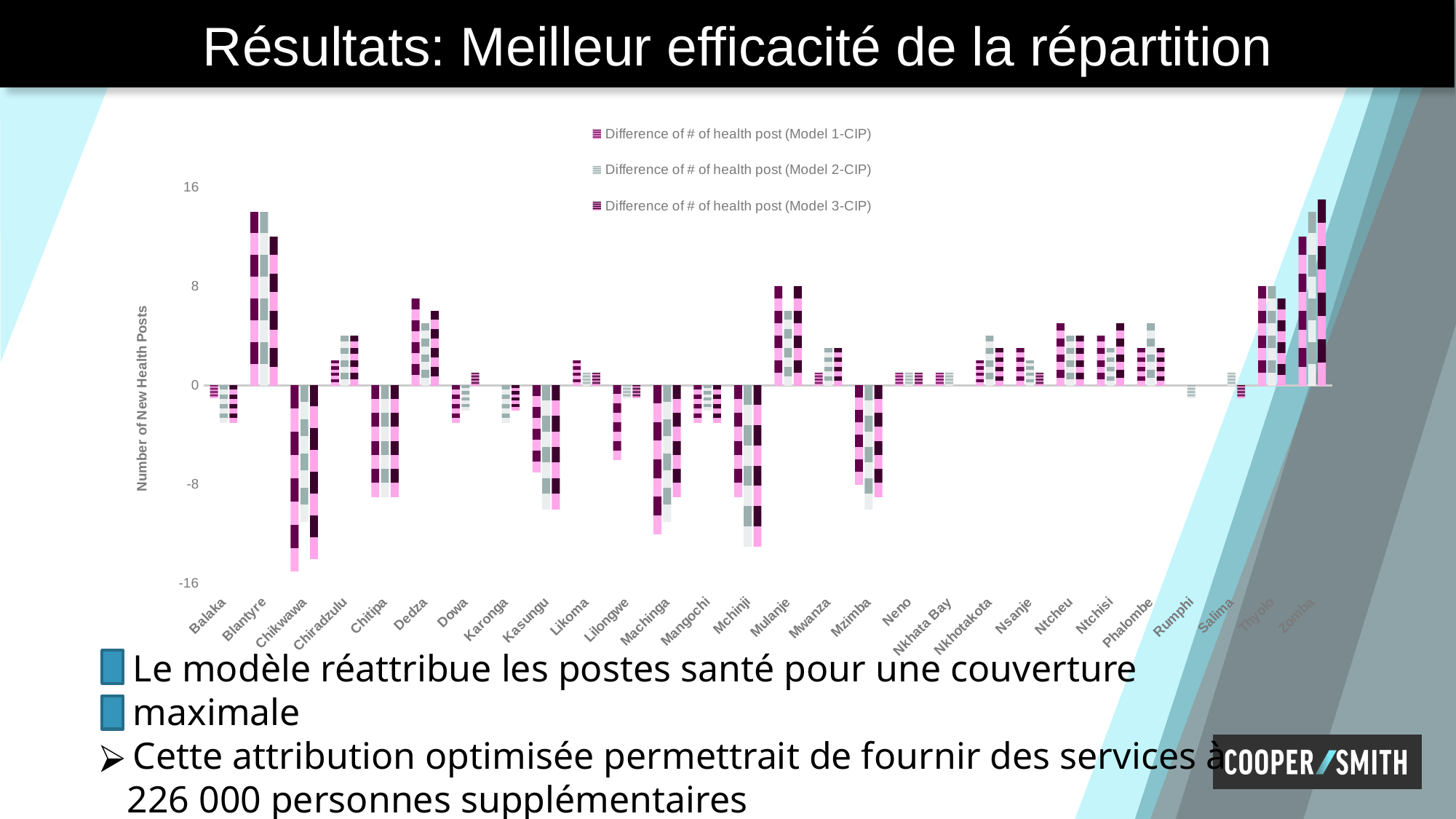
Is the value for Zomba in the Model 3-CIP series greater or less than 8? greater Is the value for Blantyre in the Model 1-CIP series greater or less than 8? greater What is the first entry in the legend? Difference of # of health post (Model 1-CIP) What is the title of the vertical axis? Number of New Health Posts What type of chart is shown on the slide? bar chart Is the value for Machinga in the Model 1-CIP series greater or less than -8? less In the Model 1-CIP series, which is larger: the value for Blantyre or the value for Dedza? Blantyre How many districts are shown along the x axis? 28 How many series does the legend list? 3